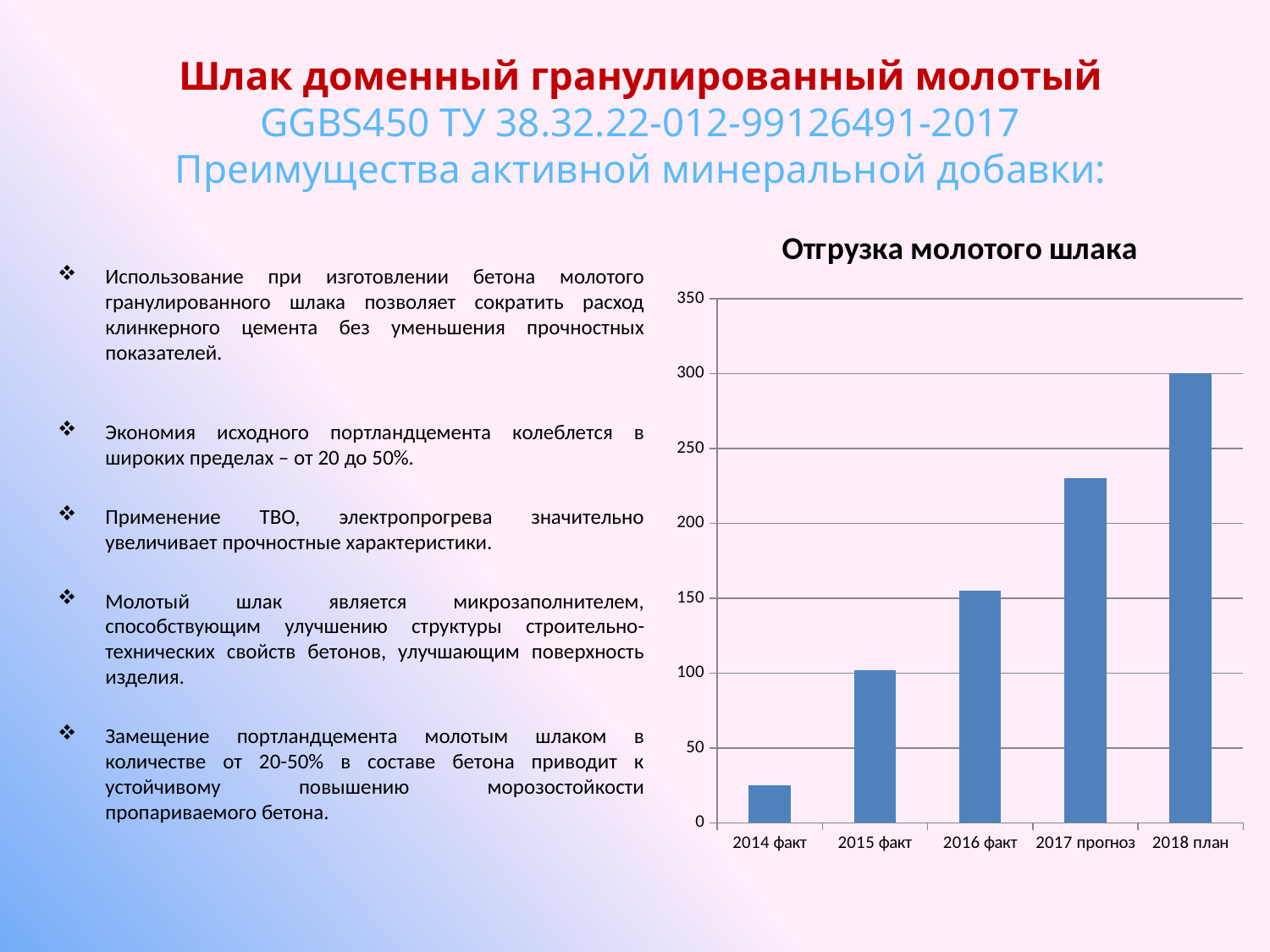
Is the value for 2017 прогноз greater or less than 250? less What kind of chart is shown on the slide? bar chart Is the value for 2014 факт greater or less than 50? less Which category has the highest value in the chart? 2018 план What is the highest value shown on the vertical axis of the chart? 350 What is the value for 2018 план? 300 Do the values rise or fall from 2014 факт to 2018 план? rise Which is larger, the value for 2015 факт or the value for 2016 факт? 2016 факт What is the title of the chart? Отгрузка молотого шлака Which category has the lowest value in the chart? 2014 факт How many categories are shown on the x axis of the chart? 5